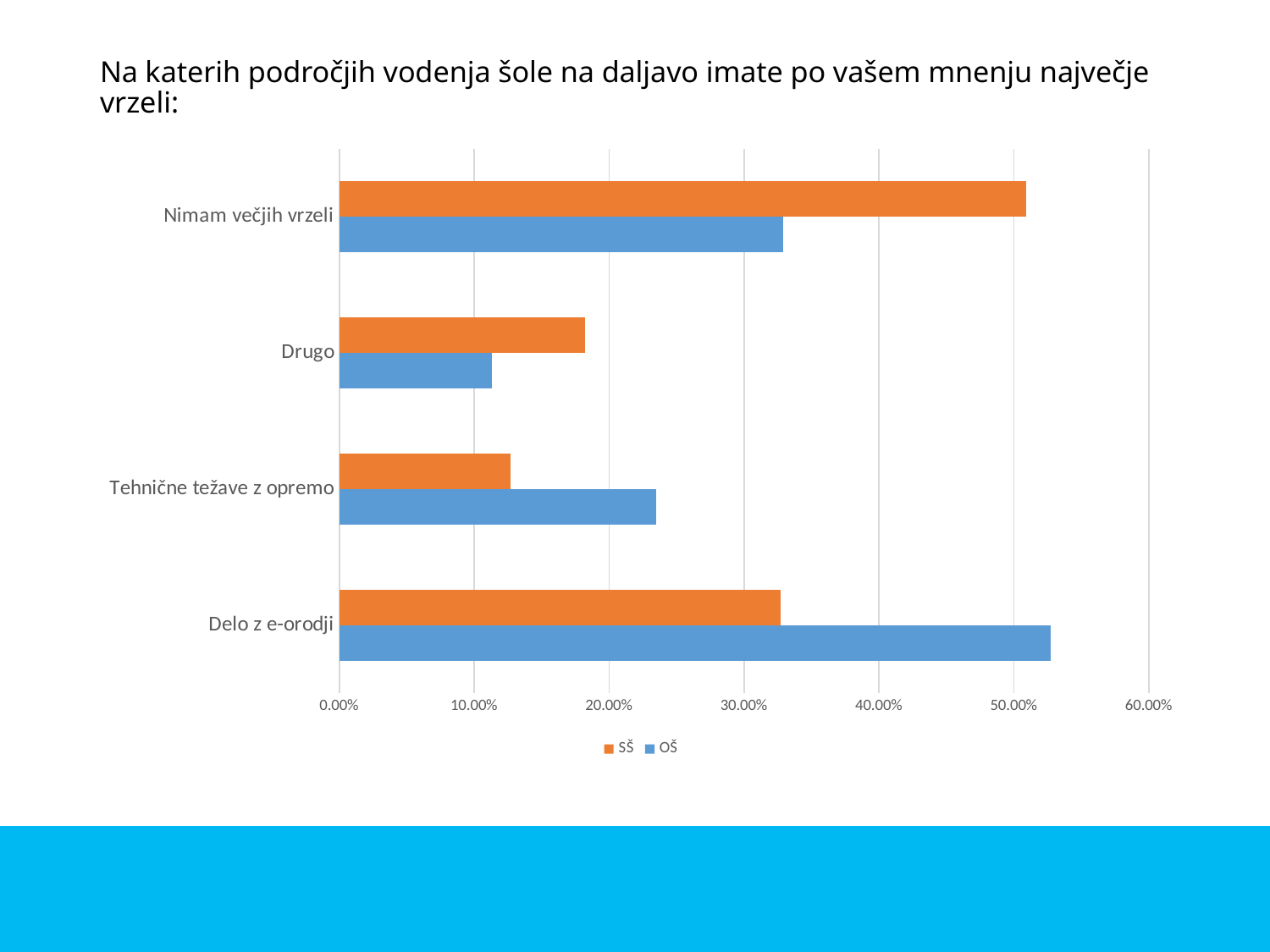
Is the OŠ value for Delo z e-orodji greater or less than 50.00%? greater Which category has the highest value for the OŠ series? Delo z e-orodji Which category has the highest value for the SŠ series? Nimam večjih vrzeli How many categories are shown on the chart? 4 Is the SŠ value for Drugo greater or less than 20.00%? less What kind of chart is shown on the slide? bar chart Which colour represents the SŠ series in the chart? orange How many series does the legend list? 2 Which category has the lowest value for the SŠ series? Tehnične težave z opremo For Delo z e-orodji, which series has the larger value, SŠ or OŠ? OŠ For Nimam večjih vrzeli, which series has the larger value, SŠ or OŠ? SŠ Which category has the lowest value for the OŠ series? Drugo